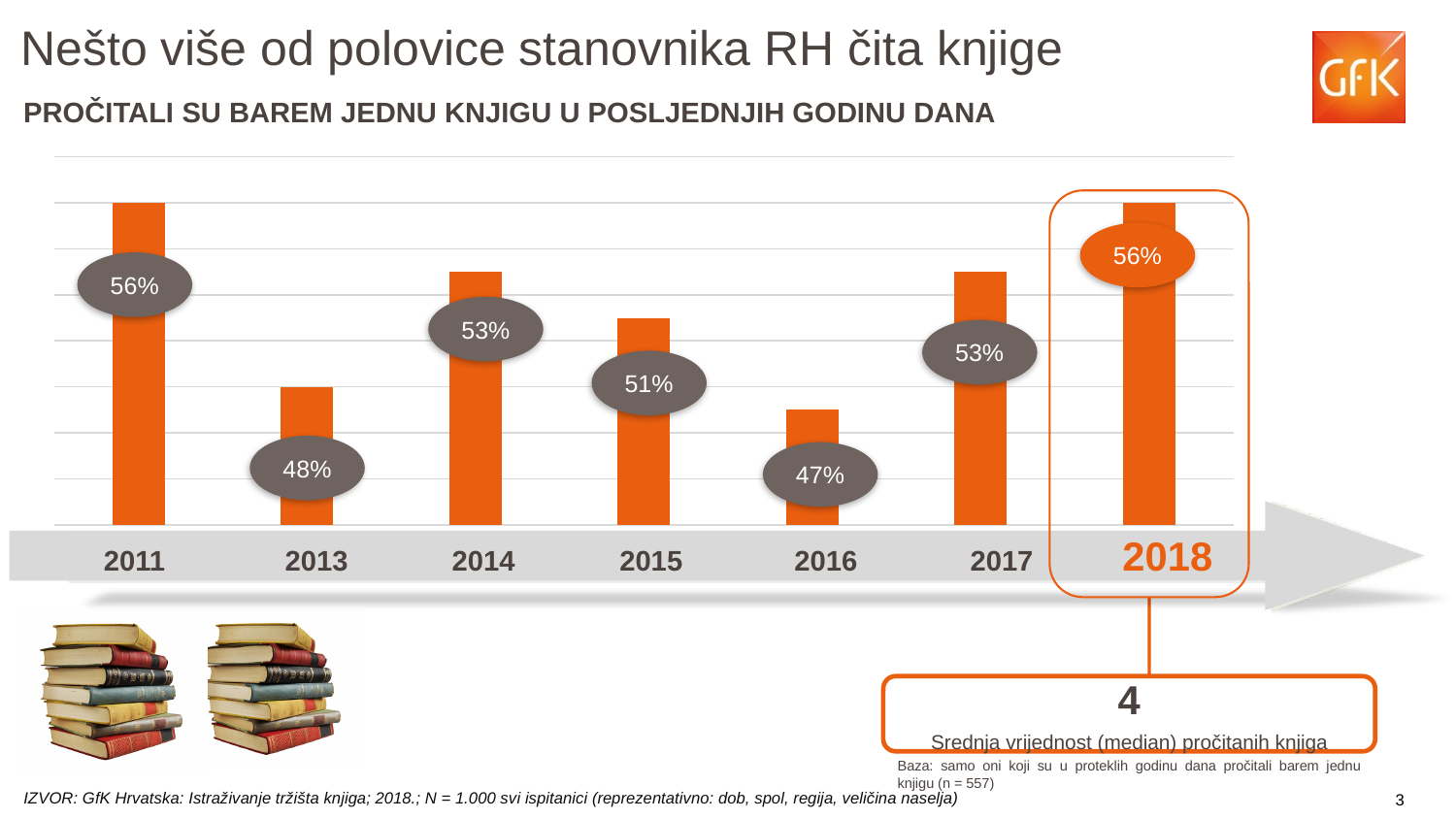
What is the value shown for 2013? 48% What is the value shown for 2015? 51% What is the median number of books read, as shown in the box below the chart? 4 Which year has the lowest share of people who read at least one book? 2016 What kind of chart is shown on the slide? Bar chart Which year has the higher value, 2013 or 2017? 2017 What is the difference in percentage points between 2018 and 2016? 9 Which year has the higher value, 2014 or 2015? 2014 What is the value shown for 2018? 56% What percentage of respondents read at least one book in the last year in 2016? 47% How many years are shown on the x axis of the chart? 7 What is the difference in percentage points between 2011 and 2013? 8